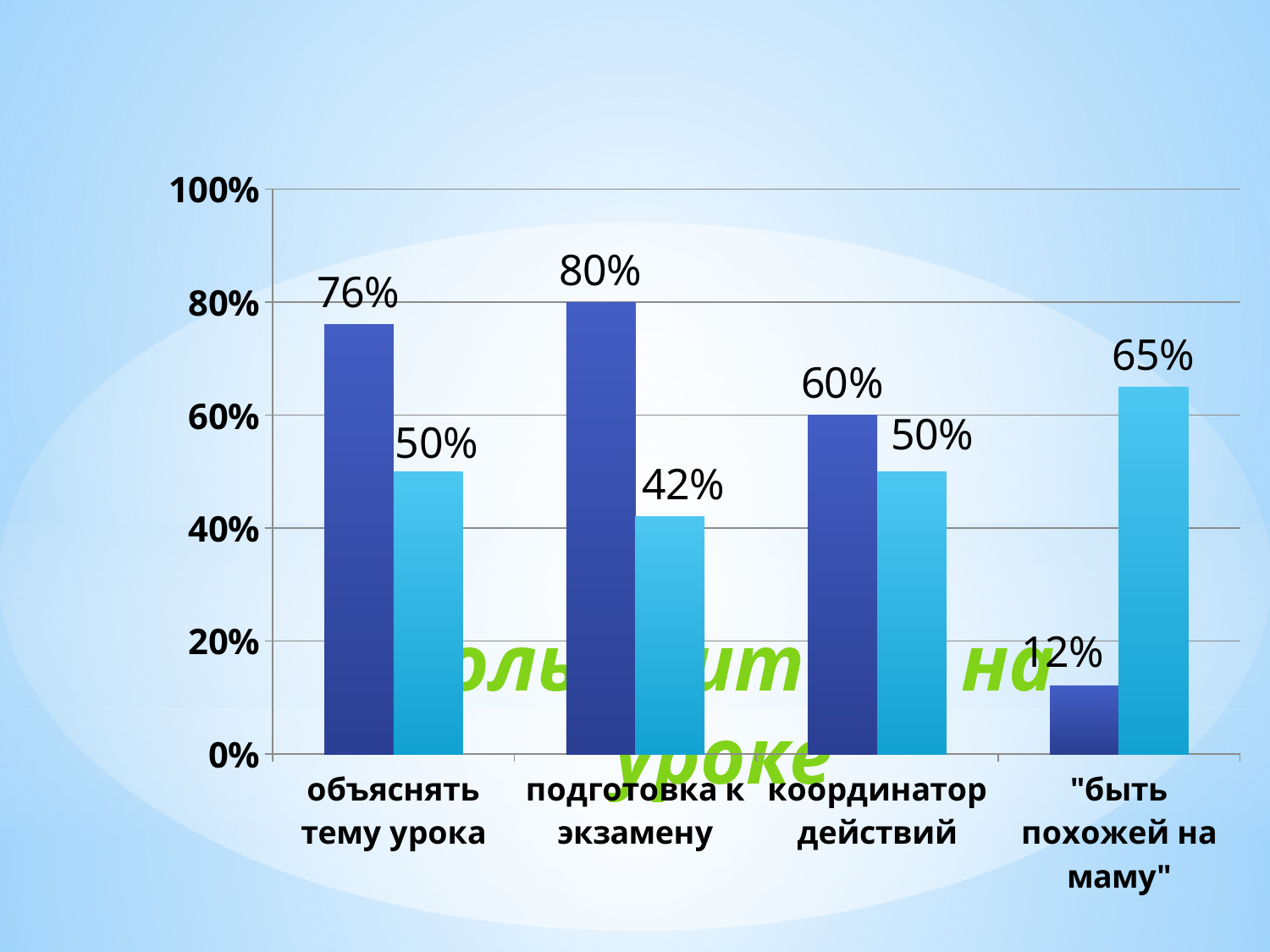
What is the difference between the dark blue bar for "объяснять тему урока" and the dark blue bar for "координатор действий"? 16% What is the value of the light blue bar for "подготовка к экзамену"? 42% What kind of chart is shown on the slide? bar chart For "быть похожей на маму", which bar is larger, the dark blue or the light blue one? light blue What is the value of the light blue bar for "быть похожей на маму"? 65% What is the difference between the dark blue and light blue bars for "подготовка к экзамену"? 38% What is the value of the dark blue bar for "координатор действий"? 60% What is the value of the dark blue bar for "объяснять тему урока"? 76% Which category has the highest dark blue bar? подготовка к экзамену Which category has the lowest light blue bar? подготовка к экзамену How many categories are shown on the x axis of the chart? 4 Which category has the lowest dark blue bar? "быть похожей на маму"